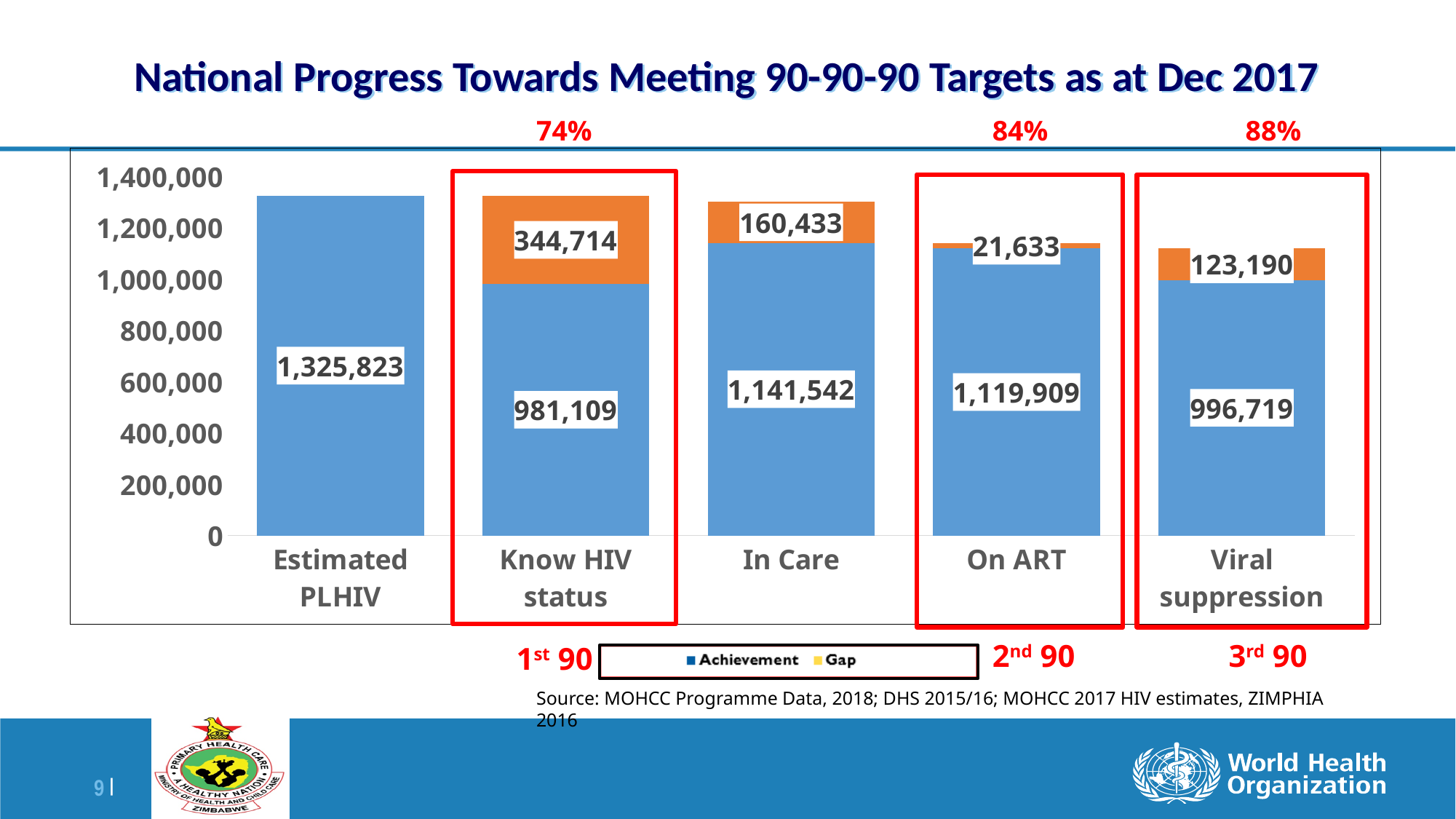
What is the Achievement value for Know HIV status? 981,109 What is the Gap value for Viral suppression? 123,190 How many series does the legend list? 2 What is the difference between the Achievement values for In Care and On ART? 21,633 What kind of chart is shown on the slide? Stacked bar chart How many categories are shown on the x axis? 5 What is the total of the stacked bar for Viral suppression (Achievement plus Gap)? 1,119,909 What is the Gap value for In Care? 160,433 Which category has the largest Gap value? Know HIV status Which category has the smallest Gap value? On ART What is the Achievement value for On ART? 1,119,909 Which is larger, the Achievement value for In Care or for Viral suppression? In Care